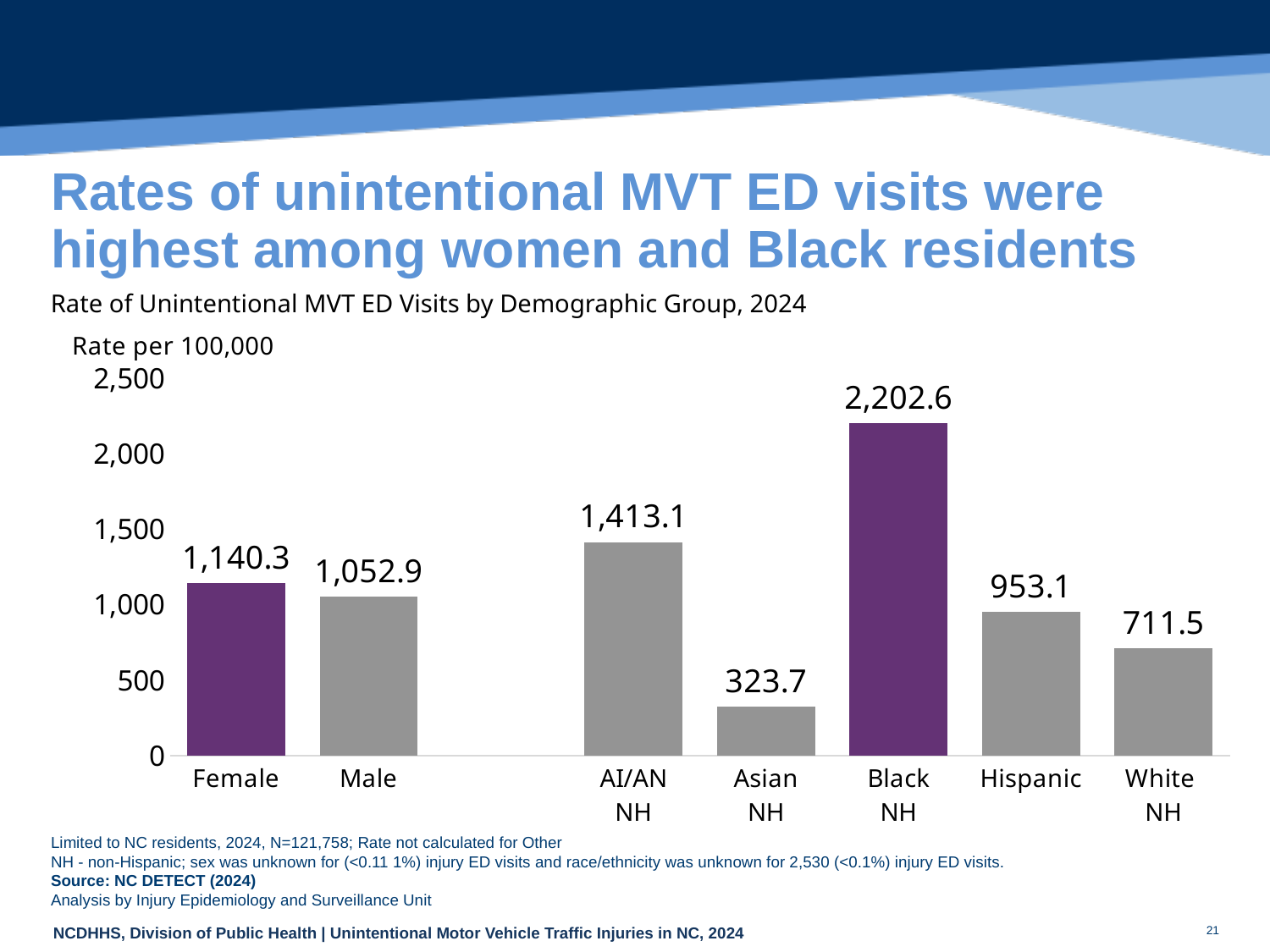
Which group has a higher rate, AI/AN NH or Hispanic? AI/AN NH What is the title of the chart? Rate of Unintentional MVT ED Visits by Demographic Group, 2024 Which demographic group has the lowest rate of unintentional MVT ED visits? Asian NH What is the rate per 100,000 of unintentional MVT ED visits for Female residents? 1,140.3 Which demographic group has the highest rate of unintentional MVT ED visits? Black NH What is the difference between the Black NH and White NH rates per 100,000? 1,491.1 What is the rate per 100,000 for Black NH residents? 2,202.6 What kind of chart is shown on the slide? Bar chart What is the difference between the Female and Male rates per 100,000? 87.4 How many demographic groups are shown in the chart? 7 What is the rate per 100,000 for Asian NH residents? 323.7 Is the rate for White NH residents greater or less than 1,000? less